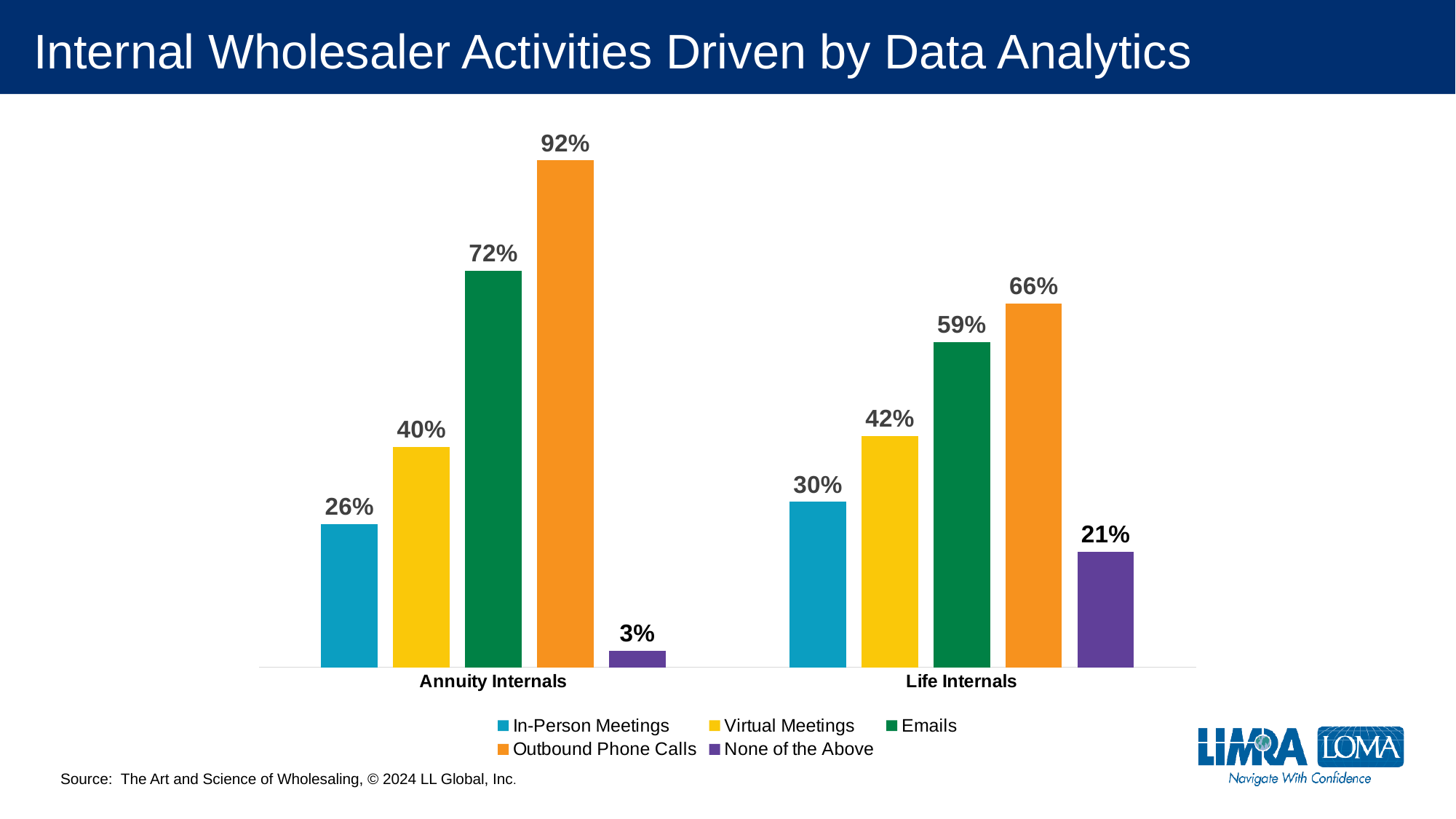
What is the difference between Outbound Phone Calls for Annuity Internals and for Life Internals? 26 percentage points Which is larger: In-Person Meetings for Annuity Internals or In-Person Meetings for Life Internals? Life Internals Which activity has the highest value for Life Internals? Outbound Phone Calls What is the value for Emails among Life Internals? 59% Which activity has the lowest value for Annuity Internals? None of the Above What is the value for None of the Above among Annuity Internals? 3% What is the value for Virtual Meetings among Life Internals? 42% What is the value for Outbound Phone Calls among Annuity Internals? 92% How many categories are shown on the x axis? 2 What kind of chart is shown on the slide? Bar chart What colour represents Emails in the chart? Green How many series does the legend list? 5